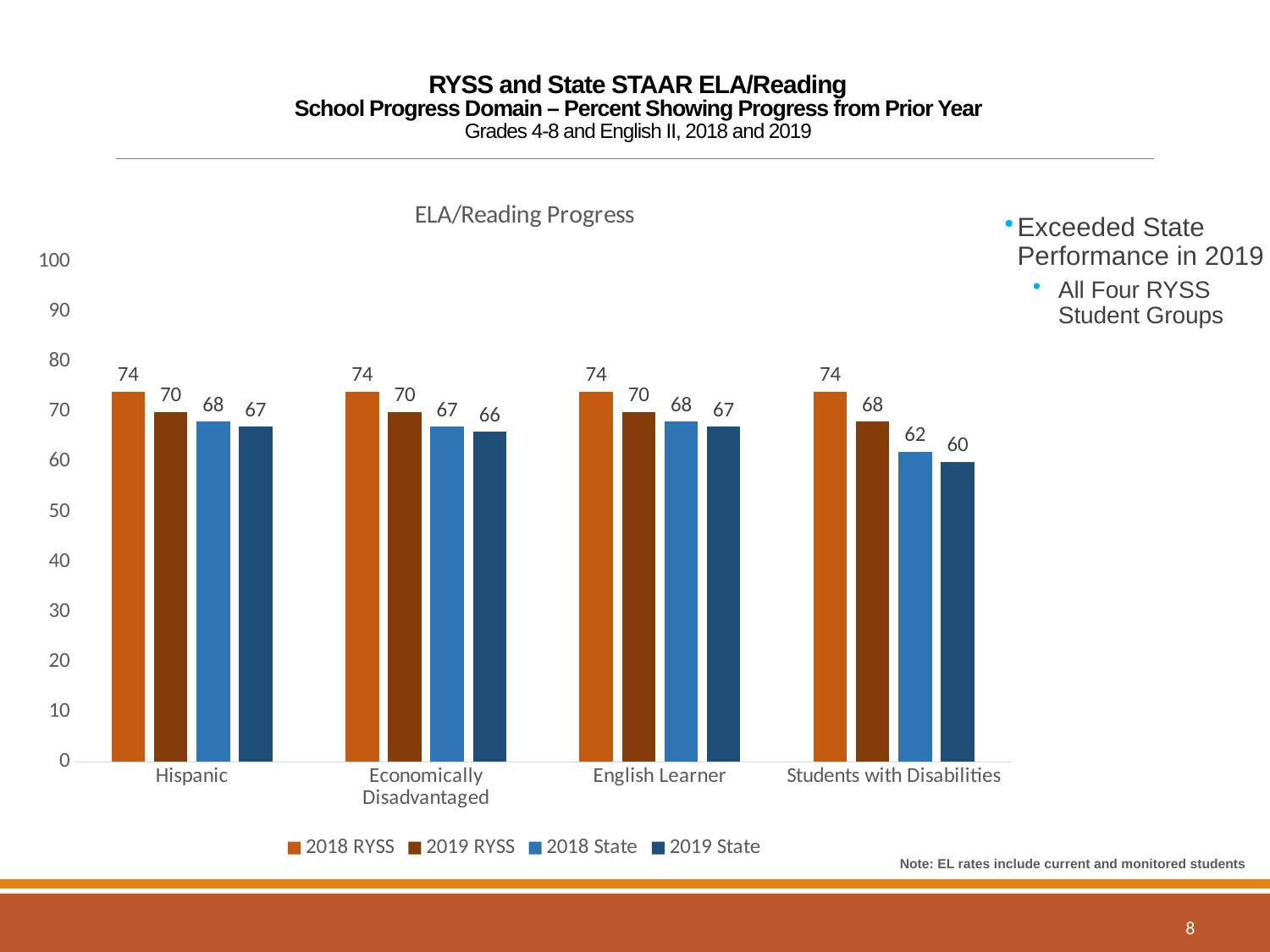
What is the title of the chart? ELA/Reading Progress How many categories are shown on the x axis? 4 What kind of chart is shown? Bar chart Which is larger for English Learner: the 2019 RYSS value or the 2019 State value? 2019 RYSS What is the difference between the 2019 RYSS and 2019 State values for Students with Disabilities? 8 What is the 2018 State value for English Learner? 68 What is the 2019 RYSS value for Students with Disabilities? 68 What is the 2019 State value for Economically Disadvantaged? 66 What is the difference between the 2018 RYSS and 2019 RYSS values for Hispanic? 4 Which series is shown in the lightest orange colour? 2018 RYSS How many series does the legend list? 4 Which category has the lowest 2019 State value? Students with Disabilities